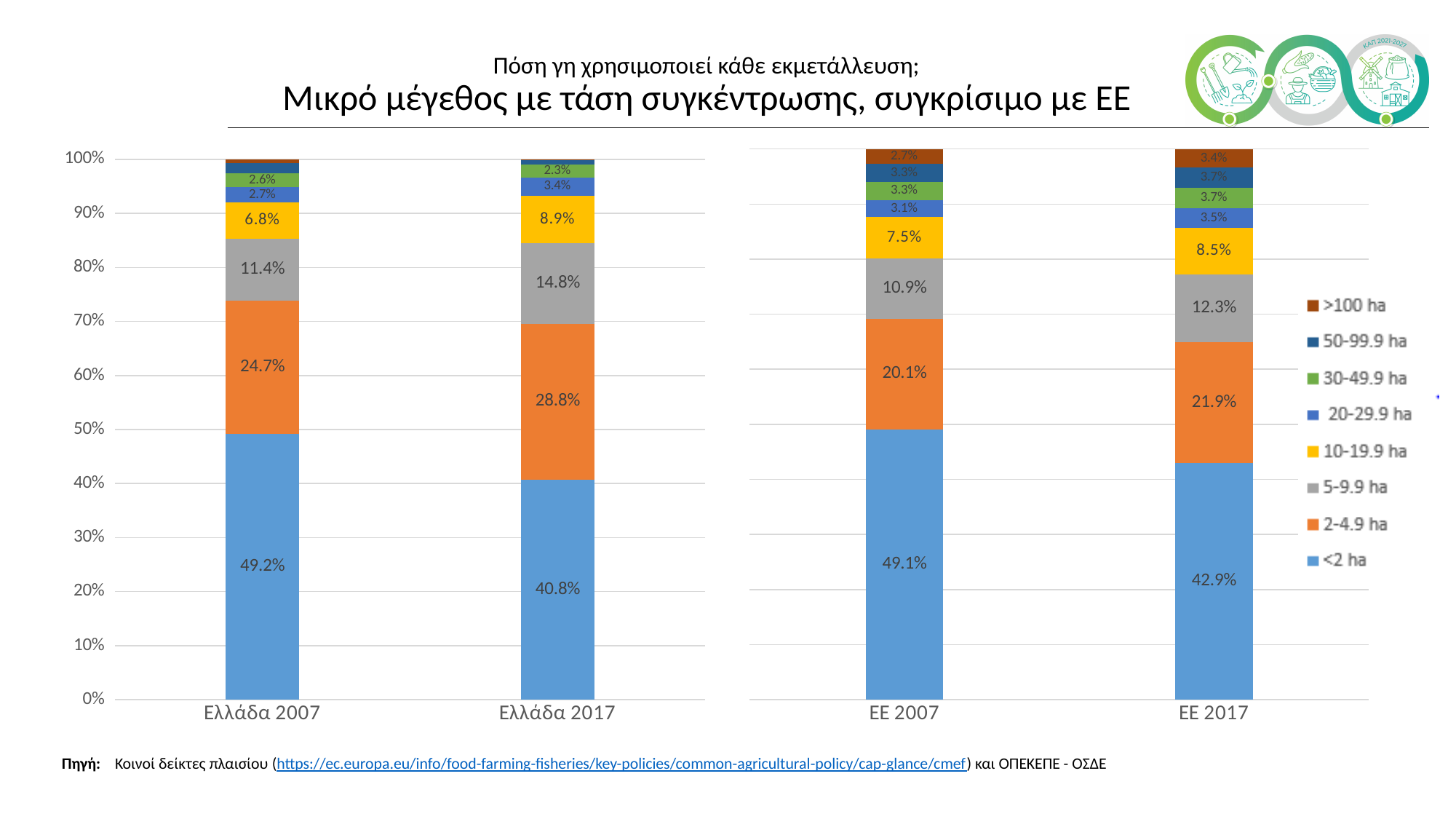
In the right chart, what is the value of the >100 ha segment for ΕΕ 2007? 2.7% In the right chart, is the <2 ha share larger for ΕΕ 2007 or ΕΕ 2017? ΕΕ 2007 In the left chart, what is the value of the 10-19.9 ha segment for Ελλάδα 2017? 8.9% In the left chart, by how many percentage points did the <2 ha share fall from Ελλάδα 2007 to Ελλάδα 2017? 8.4 percentage points In the left chart, what is the value of the 2-4.9 ha segment for Ελλάδα 2017? 28.8% How many bars are shown in the left chart? 2 In the left chart, what is the value of the <2 ha segment for Ελλάδα 2007? 49.2% How many series does the legend on the right chart list? 8 Which is larger: the 5-9.9 ha share for Ελλάδα 2017 in the left chart or for ΕΕ 2017 in the right chart? Ελλάδα 2017 What type of chart is used on this slide? Stacked bar chart In the right chart, what is the value of the 5-9.9 ha segment for ΕΕ 2017? 12.3% In the right chart, what is the difference between the 2-4.9 ha values for ΕΕ 2017 and ΕΕ 2007? 1.8 percentage points